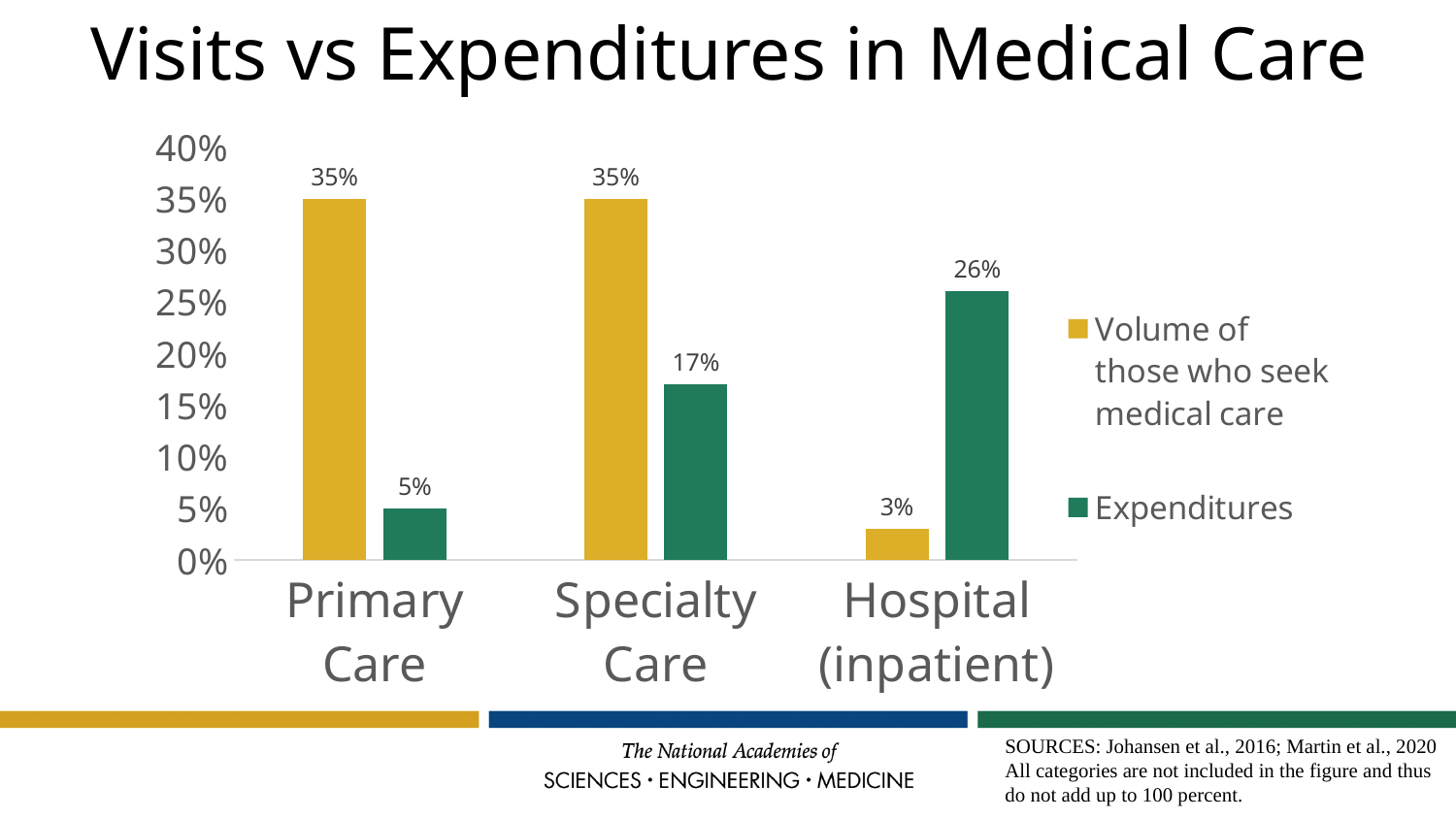
What is the Volume of those who seek medical care value for Primary Care? 35% What is the difference between the Volume of those who seek medical care and Expenditures values for Primary Care? 30% Which category has the highest Expenditures value? Hospital (inpatient) How many series does the legend list? 2 What is the Volume of those who seek medical care value for Hospital (inpatient)? 3% What kind of chart is shown on the slide? Bar chart What is the Expenditures value for Specialty Care? 17% Which is larger for Specialty Care: Volume of those who seek medical care or Expenditures? Volume of those who seek medical care What is the Expenditures value for Hospital (inpatient)? 26% Is the Expenditures value for Hospital (inpatient) greater or less than 20%? greater How many categories are shown on the x axis? 3 Which category has the lowest Volume of those who seek medical care value? Hospital (inpatient)